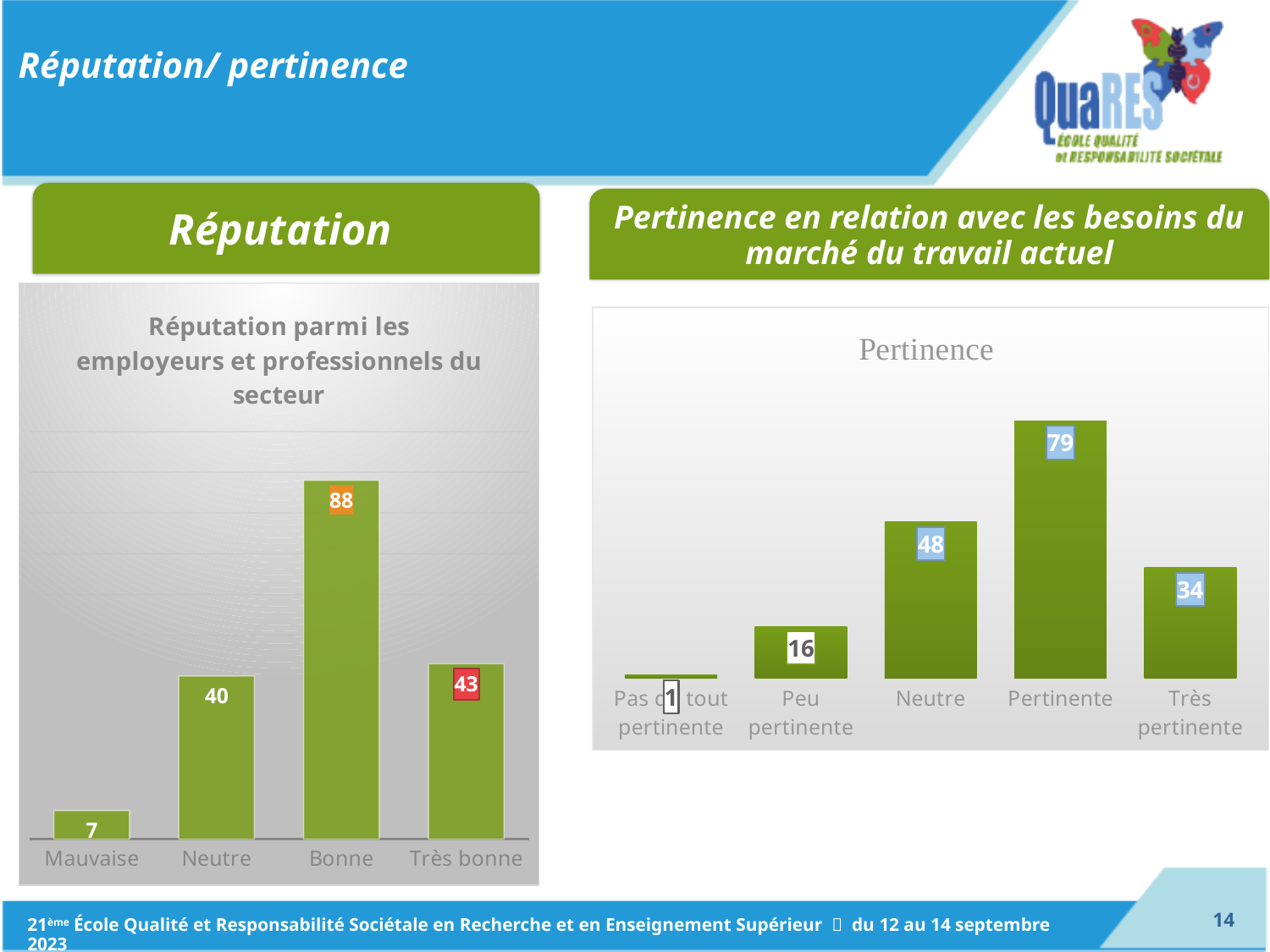
In the 'Réputation parmi les employeurs et professionnels du secteur' chart, what is the value for Mauvaise? 7 In the 'Réputation parmi les employeurs et professionnels du secteur' chart, which category has the lowest value? Mauvaise In the 'Réputation parmi les employeurs et professionnels du secteur' chart, what is the difference between Bonne and Très bonne? 45 In the 'Réputation parmi les employeurs et professionnels du secteur' chart, which category has the highest value? Bonne What kind of chart is the 'Pertinence' chart? Bar chart In the 'Pertinence' chart, what is the difference between Pertinente and Neutre? 31 In the 'Pertinence' chart, what is the value for Pertinente? 79 In the 'Réputation parmi les employeurs et professionnels du secteur' chart, how many categories are shown? 4 In the 'Pertinence' chart, which is larger, Neutre or Très pertinente? Neutre In the 'Pertinence' chart, what is the value for Peu pertinente? 16 In the 'Réputation parmi les employeurs et professionnels du secteur' chart, what is the value for Bonne? 88 In the 'Pertinence' chart, which category has the lowest value? Pas du tout pertinente